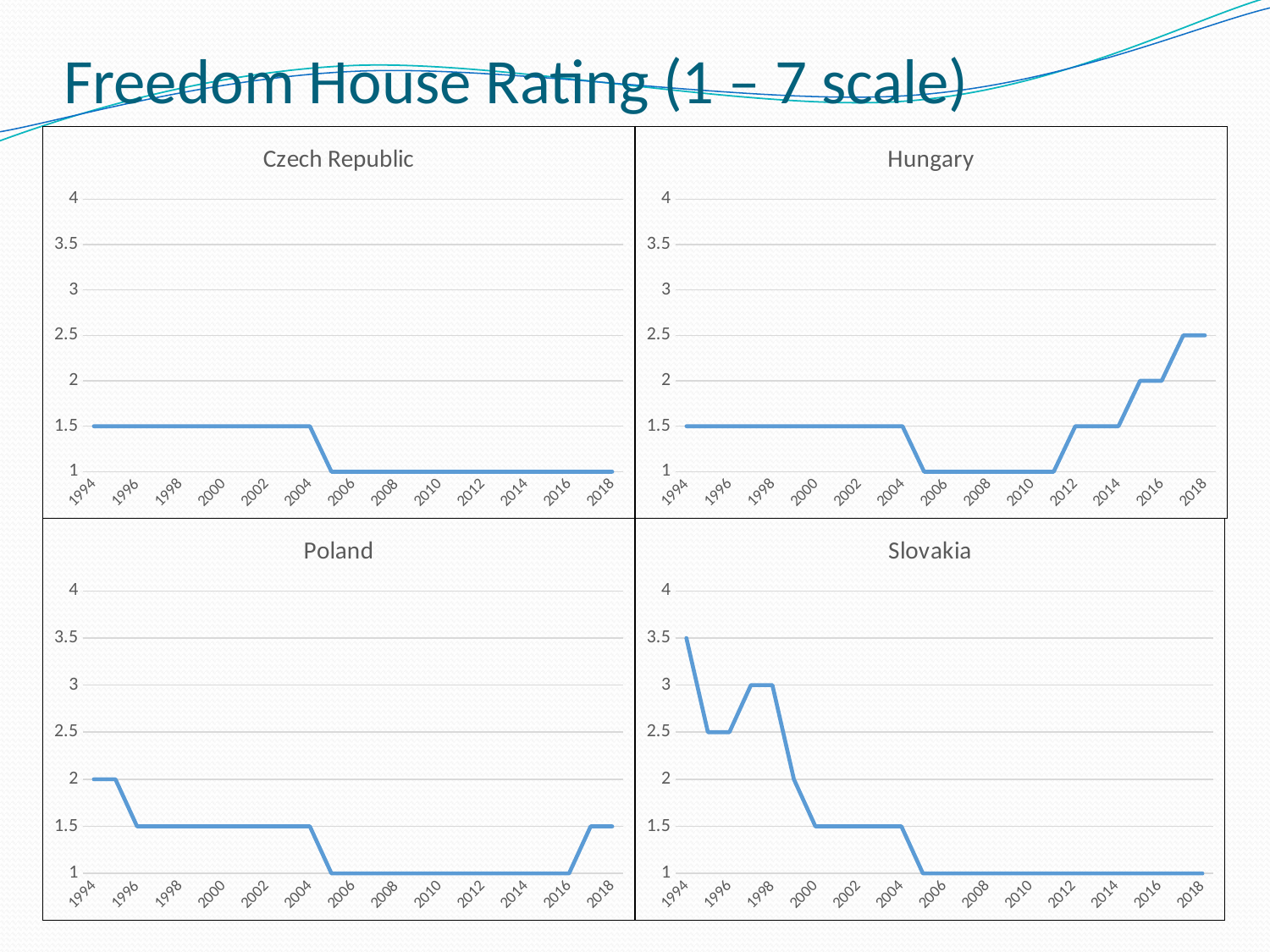
What kind of chart is the Czech Republic chart? line chart In the Hungary chart, does the rating rise or fall between 2012 and 2018? rise In the Czech Republic chart, what is the rating in 2018? 1 In the Slovakia chart, which year has the highest rating? 1994 How many charts are shown on the slide? 4 In the Czech Republic chart, what is the rating in 1994? 1.5 In the Slovakia chart, does the rating rise or fall between 1994 and 2018? fall In the Poland chart, what is the rating in 1994? 2 Which is larger in 2018: the rating in the Hungary chart or the rating in the Czech Republic chart? Hungary In the Hungary chart, what is the difference between the rating in 2018 and the rating in 2010? 1.5 In the Slovakia chart, what is the rating in 1994? 3.5 In the Hungary chart, what is the rating in 2018? 2.5